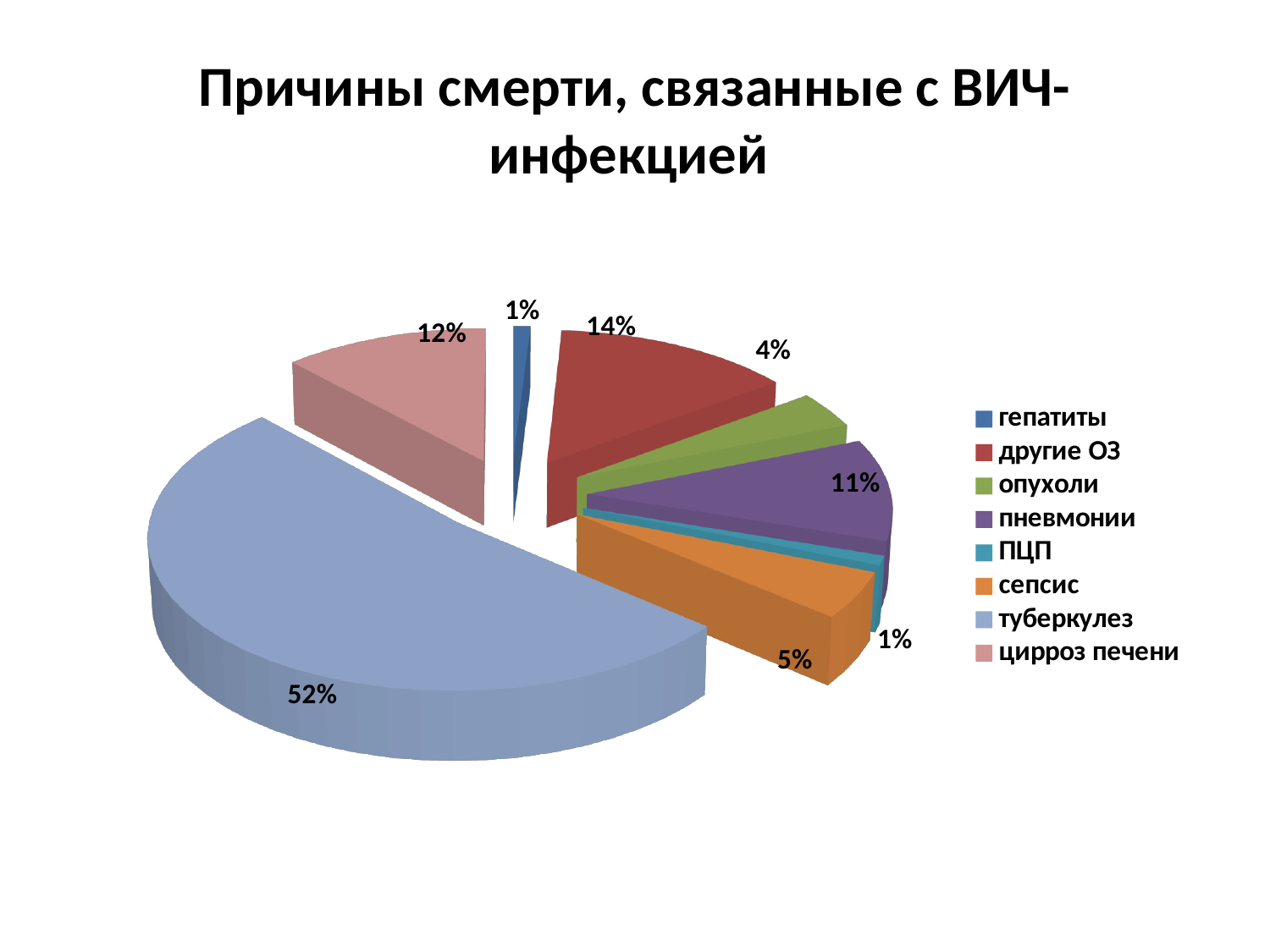
What is the value shown for цирроз печени? 12% Which is larger, the value for опухоли or the value for сепсис? сепсис What share of the pie does туберкулез account for? 52% What is the difference between the values for туберкулез and другие ОЗ? 38% What is the value shown for другие ОЗ? 14% What is the title of the chart? Причины смерти, связанные с ВИЧ-инфекцией What is the difference between the values for цирроз печени and пневмонии? 1% Which category has the largest slice of the pie? туберкулез How many categories does the legend list? 8 What is the value shown for сепсис? 5% What kind of chart is shown on the slide? pie chart What is the value shown for пневмонии? 11%